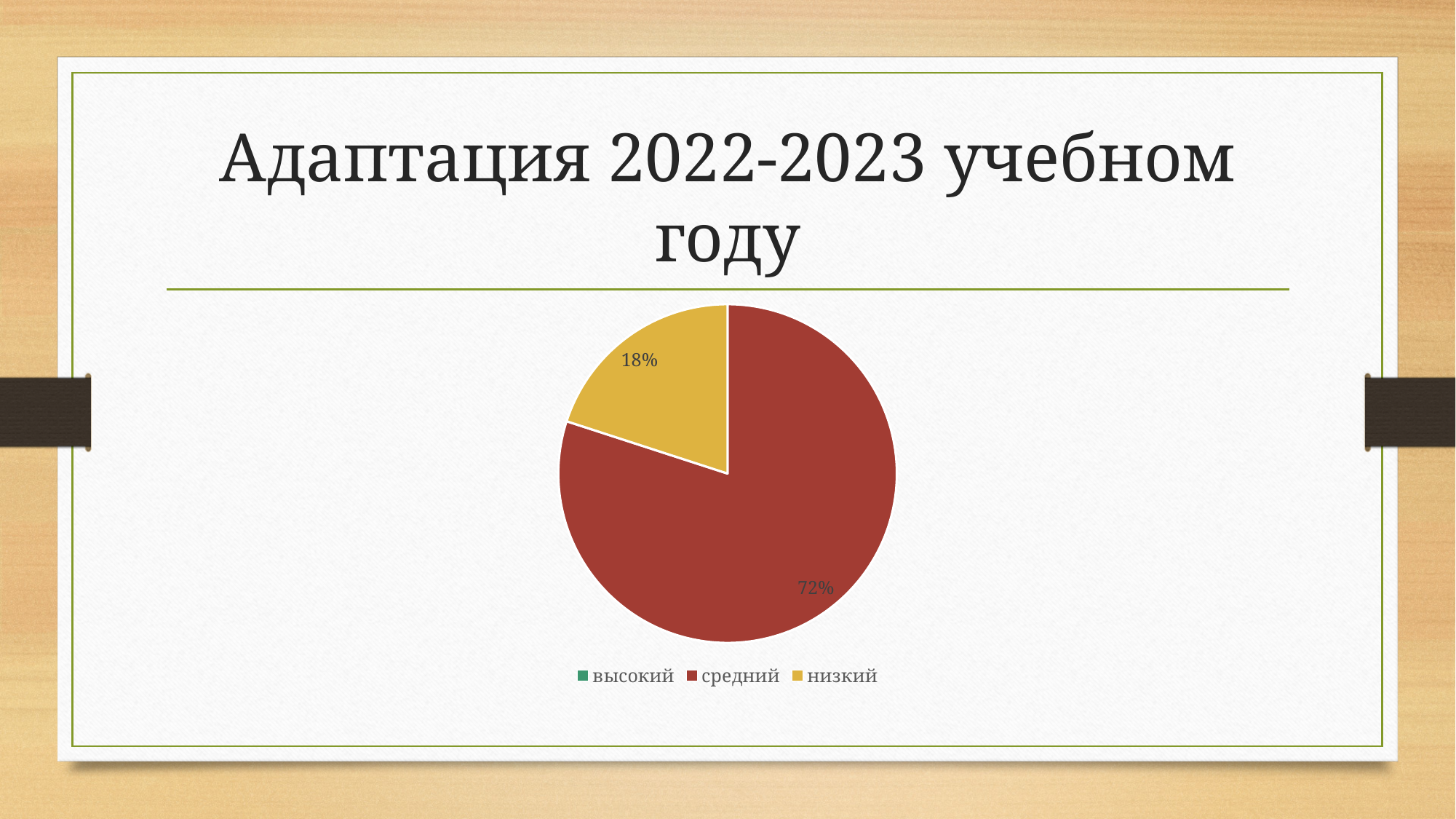
By how many percentage points does the средний slice exceed the низкий slice? 54 percentage points Which labelled slice of the pie is the largest? средний What kind of chart is shown on the slide? Pie chart What colour is the средний slice of the pie? Red What share of the pie does the низкий slice represent? 18% How many entries does the legend list? 3 What is the title of the slide containing the chart? Адаптация 2022-2023 учебном году Is the share for средний greater or less than 50%? greater What share of the pie does the средний slice represent? 72% Which is larger, the средний slice or the низкий slice? средний